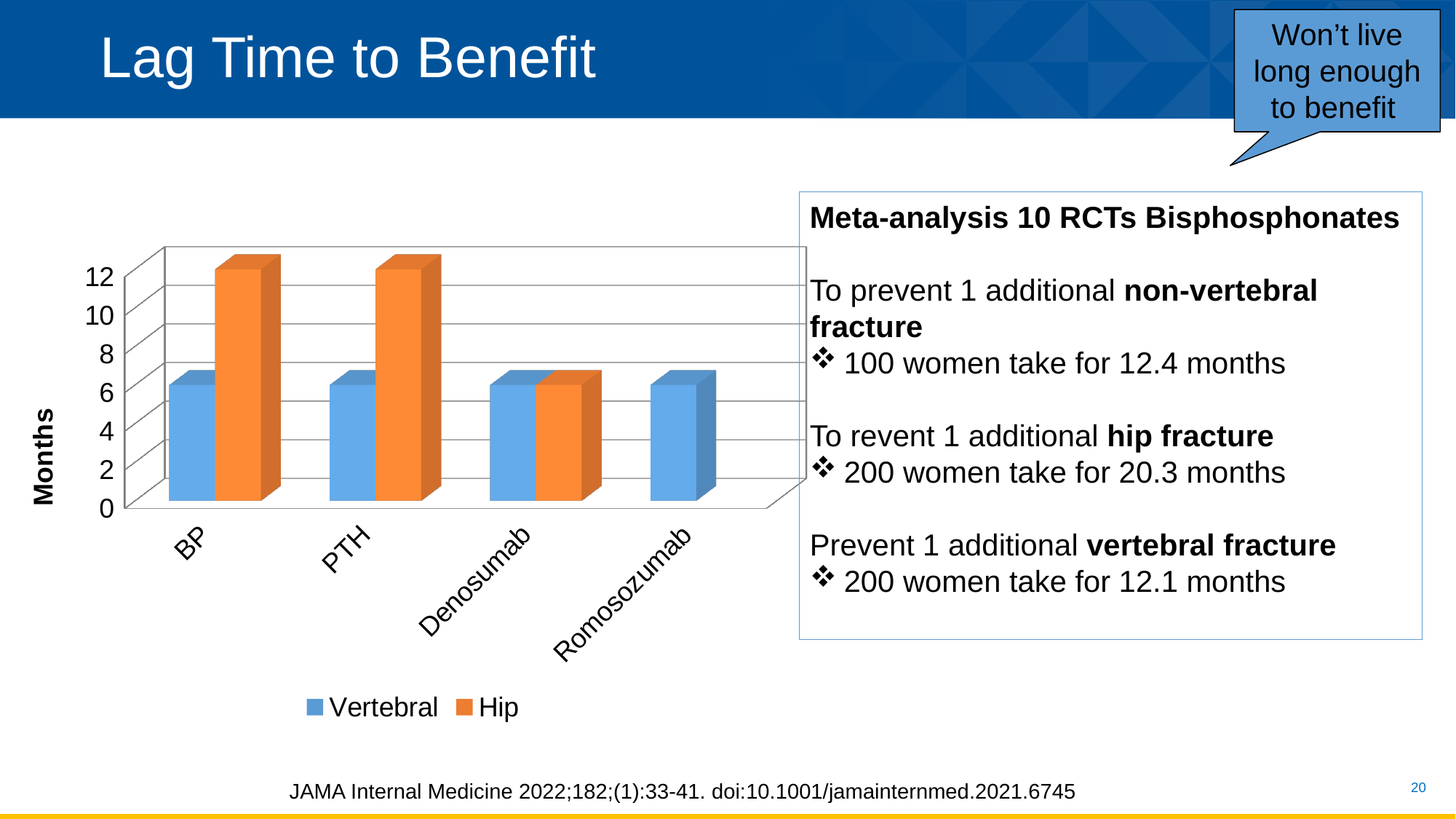
How many categories are shown on the x axis of the chart? 4 What kind of chart is shown on the slide? bar chart Is the Vertebral value for BP greater or less than 8? less Is the Hip value for Denosumab greater or less than 10? less Which is larger: the Hip value for PTH or the Hip value for Denosumab? PTH How many series does the chart legend list? 2 What is the title of the vertical axis of the chart? Months Among BP, PTH and Denosumab, which category has the lowest Hip value? Denosumab What are the two series named in the chart legend? Vertebral and Hip Is the Vertebral value for Romosozumab greater or less than 4? greater For BP, which is larger: the Vertebral value or the Hip value? Hip